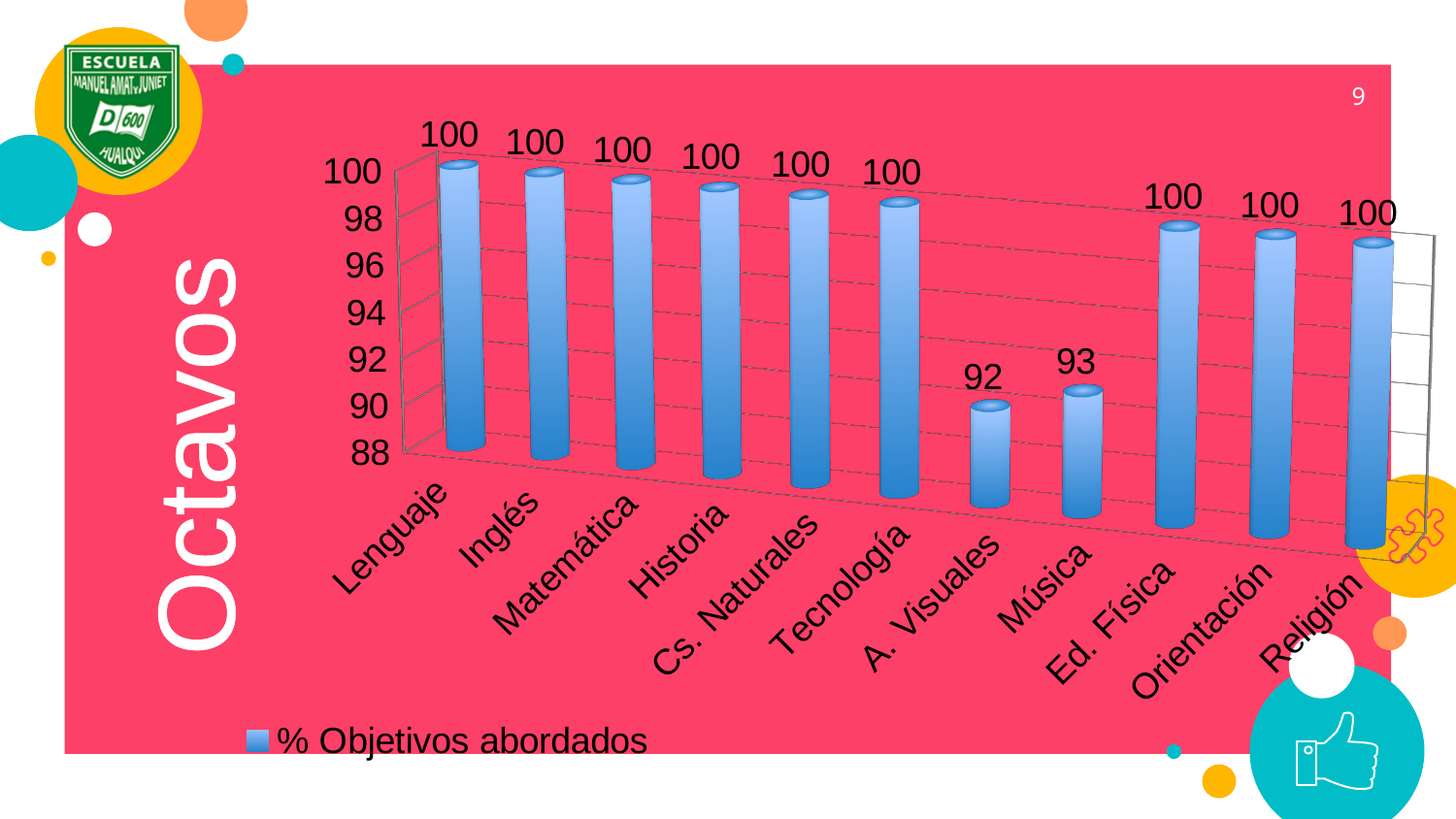
Which category has the lowest value? A. Visuales What is the value for A. Visuales? 92 What is the difference between the values for Tecnología and A. Visuales? 8 What is the value for Ed. Física? 100 Is the value for A. Visuales greater or less than 94? less What is the difference between the values for Música and A. Visuales? 1 How many categories are shown on the x axis? 11 What is the value for Música? 93 What series name does the legend show? % Objetivos abordados What is the value for Lenguaje? 100 Which is larger, the value for Música or the value for A. Visuales? Música What kind of chart is shown on the slide? bar chart